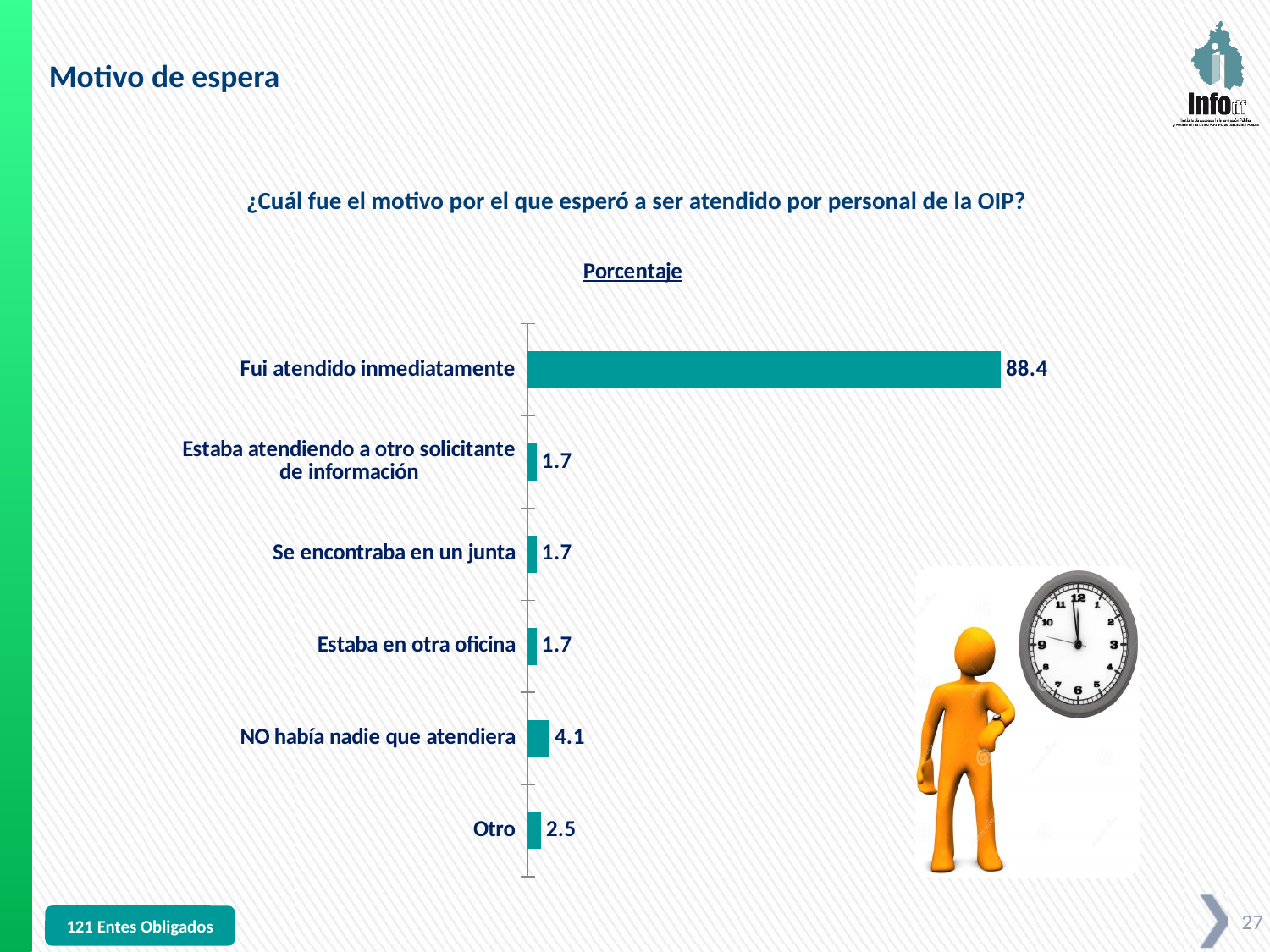
What is the difference between the values for "Fui atendido inmediatamente" and "NO había nadie que atendiera"? 84.3 What kind of chart is shown on the slide? Bar chart How many categories are shown in the chart? 6 What is the value for "Fui atendido inmediatamente"? 88.4 What is the value for "Se encontraba en un junta"? 1.7 What is the value for "Otro"? 2.5 What is the title of the chart? Porcentaje What is the difference between the values for "NO había nadie que atendiera" and "Otro"? 1.6 Which is larger, the value for "Otro" or the value for "Estaba en otra oficina"? Otro Which category has the highest value? Fui atendido inmediatamente How many categories have a value of 1.7? 3 What is the value for "NO había nadie que atendiera"? 4.1